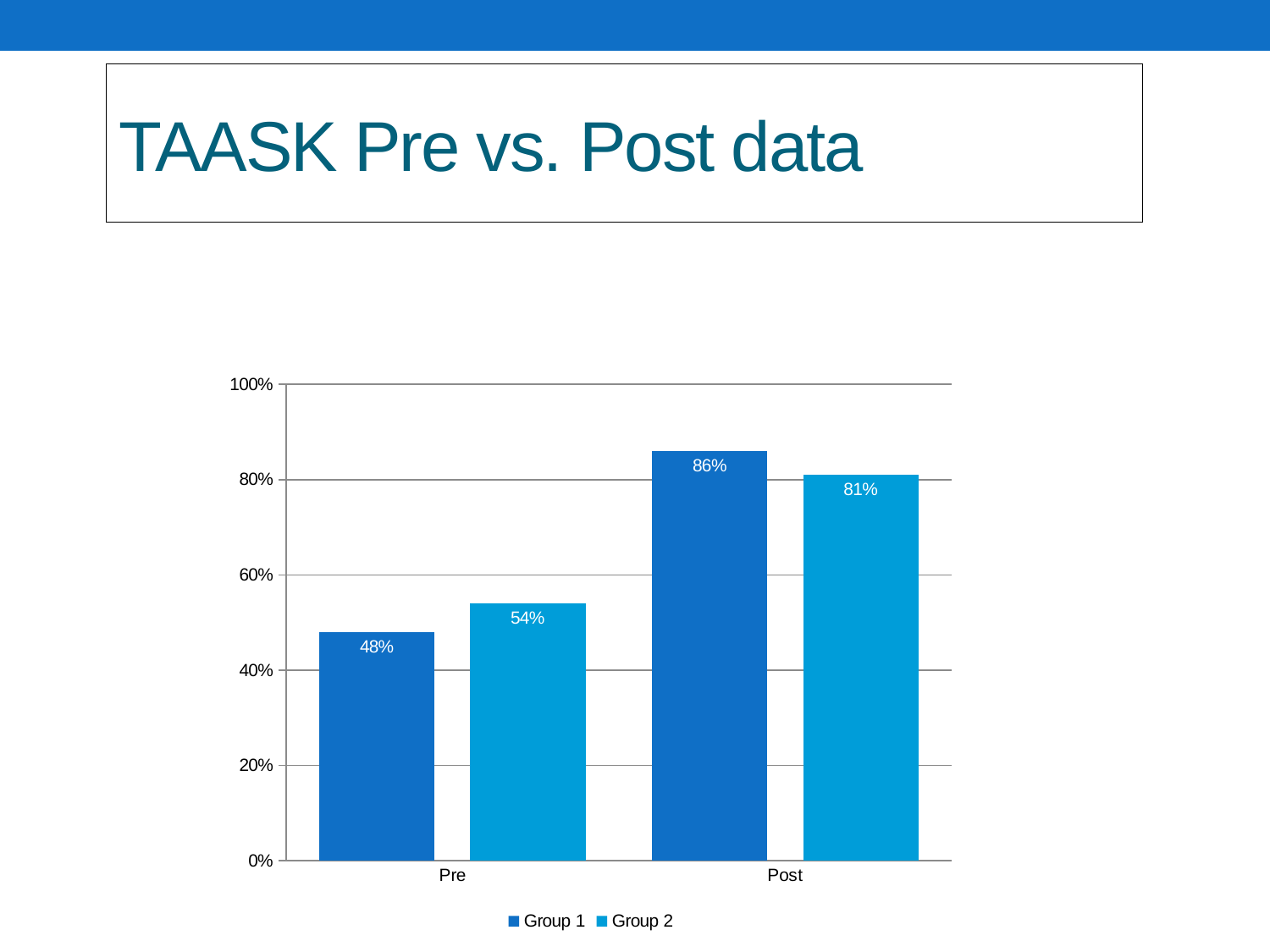
Which group has the highest value in the Post category? Group 1 How many categories are shown on the x axis? 2 In the Pre category, which is larger: Group 1 or Group 2? Group 2 What is the value for Group 1 in the Pre category? 48% What is the value for Group 2 in the Post category? 81% What kind of chart is shown on the slide? Bar chart What is the difference between Group 1 and Group 2 in the Post category? 5% Which bar has the lowest value on the chart? Group 1, Pre How many series does the legend list? 2 What is the value for Group 2 in the Pre category? 54% Do the values for Group 2 rise or fall from Pre to Post? Rise What is the difference between Group 1's Post and Pre values? 38%